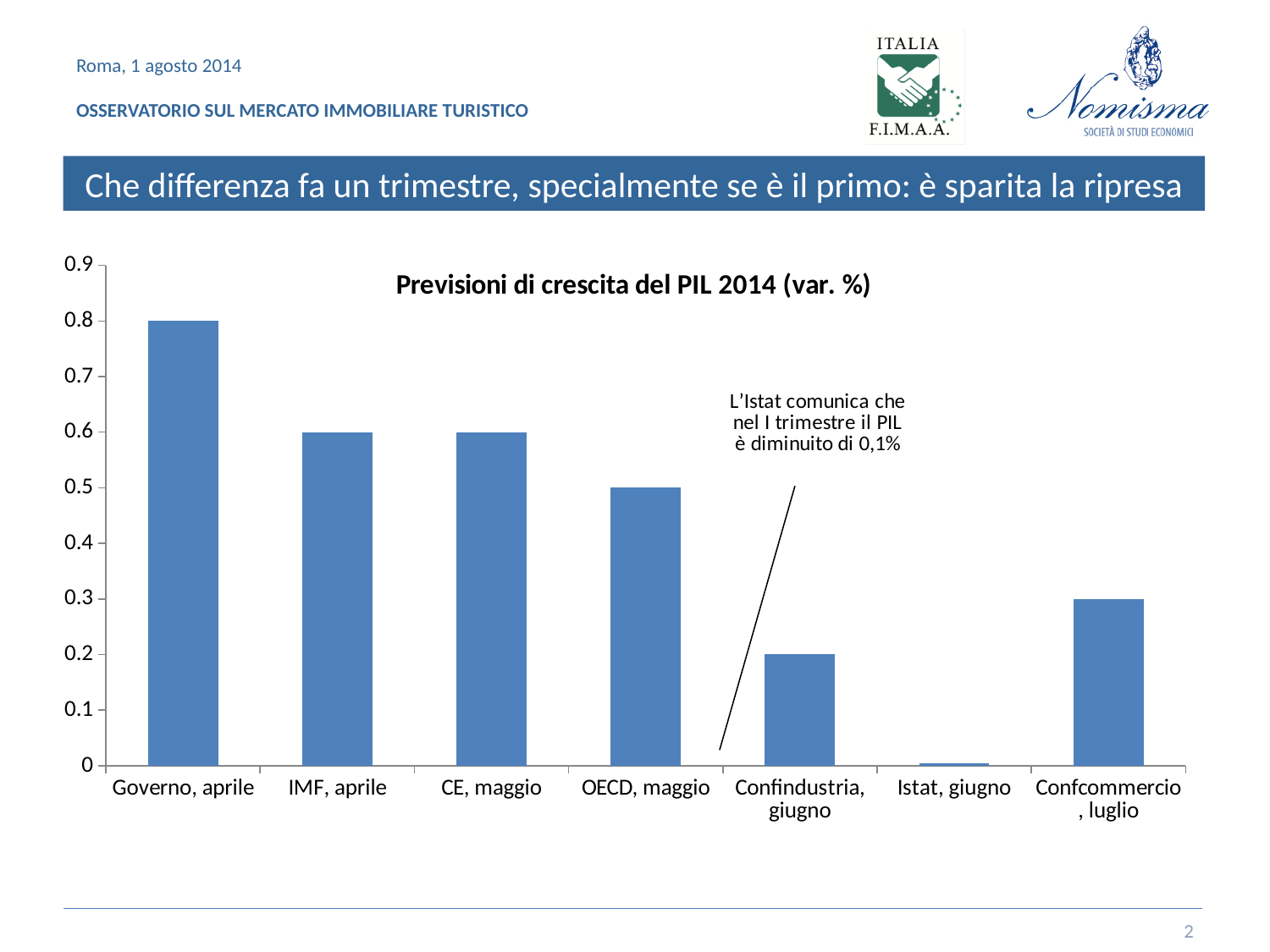
Which category has the highest value? Governo, aprile What is the value for Confindustria, giugno? 0.2 How many categories (forecasts) are shown in the chart? 7 What type of chart is shown on the slide? bar chart What is the value for OECD, maggio? 0.5 Is the value for Istat, giugno greater or less than 0.1? less What is the value for Confcommercio, luglio? 0.3 What is the title of the chart? Previsioni di crescita del PIL 2014 (var. %) What is the difference between the values for Governo, aprile and Confindustria, giugno? 0.6 Which is larger, the value for OECD, maggio or the value for Confcommercio, luglio? OECD, maggio Which category has the lowest value? Istat, giugno What is the value for Governo, aprile? 0.8